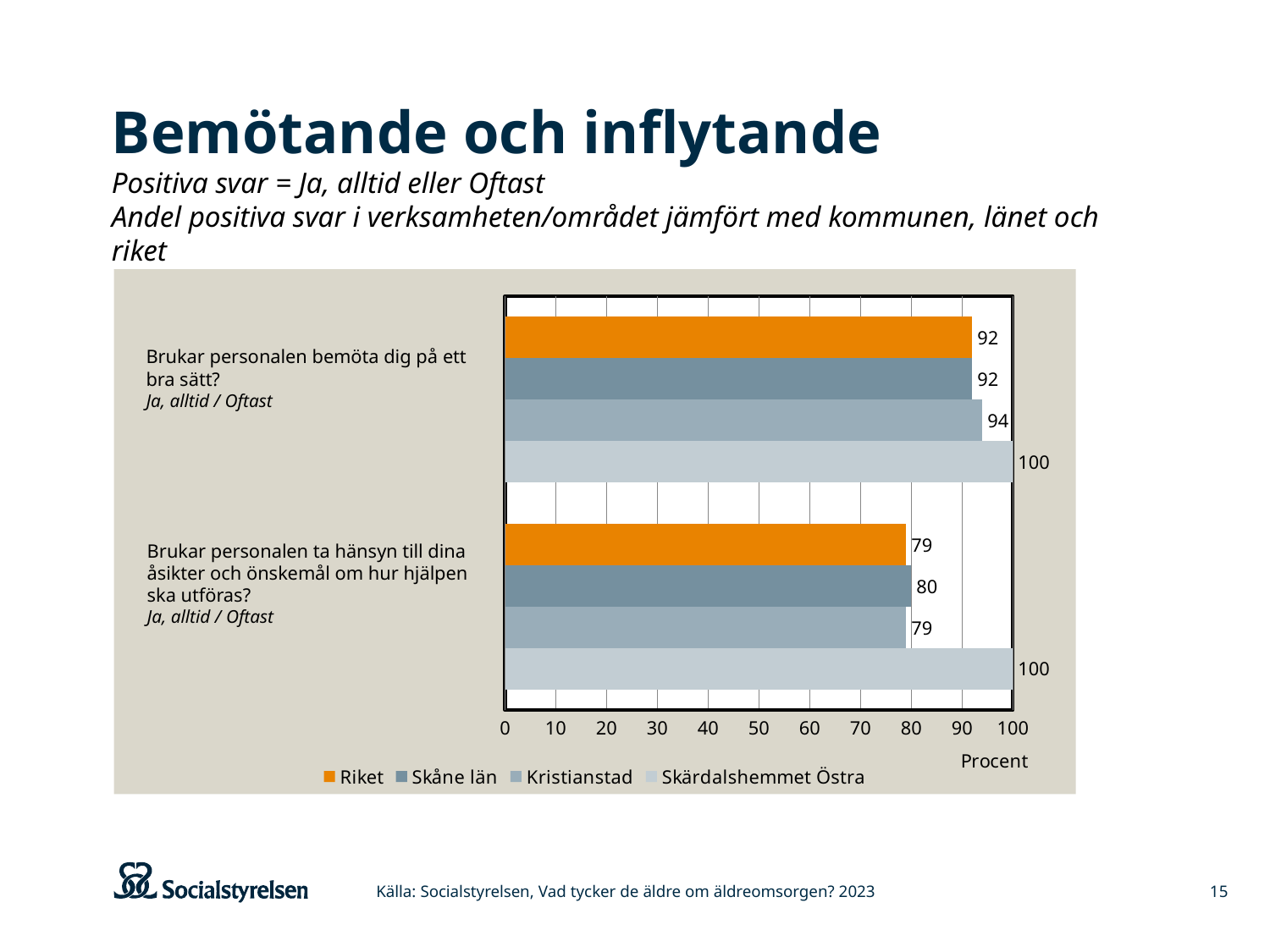
What is the value for Skärdalshemmet Östra for the question "Brukar personalen ta hänsyn till dina åsikter och önskemål om hur hjälpen ska utföras?"? 100 What is the difference between Skärdalshemmet Östra and Riket for the question "Brukar personalen ta hänsyn till dina åsikter och önskemål om hur hjälpen ska utföras?"? 21 Which series has the lowest value for the question "Brukar personalen ta hänsyn till dina åsikter och önskemål om hur hjälpen ska utföras?"? Riket and Kristianstad (both 79) For the question "Brukar personalen bemöta dig på ett bra sätt?", which is larger: Kristianstad or Skåne län? Kristianstad What unit is shown on the horizontal axis of the chart? Procent How many series does the legend list? 4 What is the value for Skåne län for the question "Brukar personalen ta hänsyn till dina åsikter och önskemål om hur hjälpen ska utföras?"? 80 Which series has the highest value for the question "Brukar personalen bemöta dig på ett bra sätt?"? Skärdalshemmet Östra What is the value for Riket for the question "Brukar personalen bemöta dig på ett bra sätt?"? 92 What is the value for Kristianstad for the question "Brukar personalen bemöta dig på ett bra sätt?"? 94 How many questions (categories) are shown on the chart? 2 What kind of chart is shown on the slide? bar chart